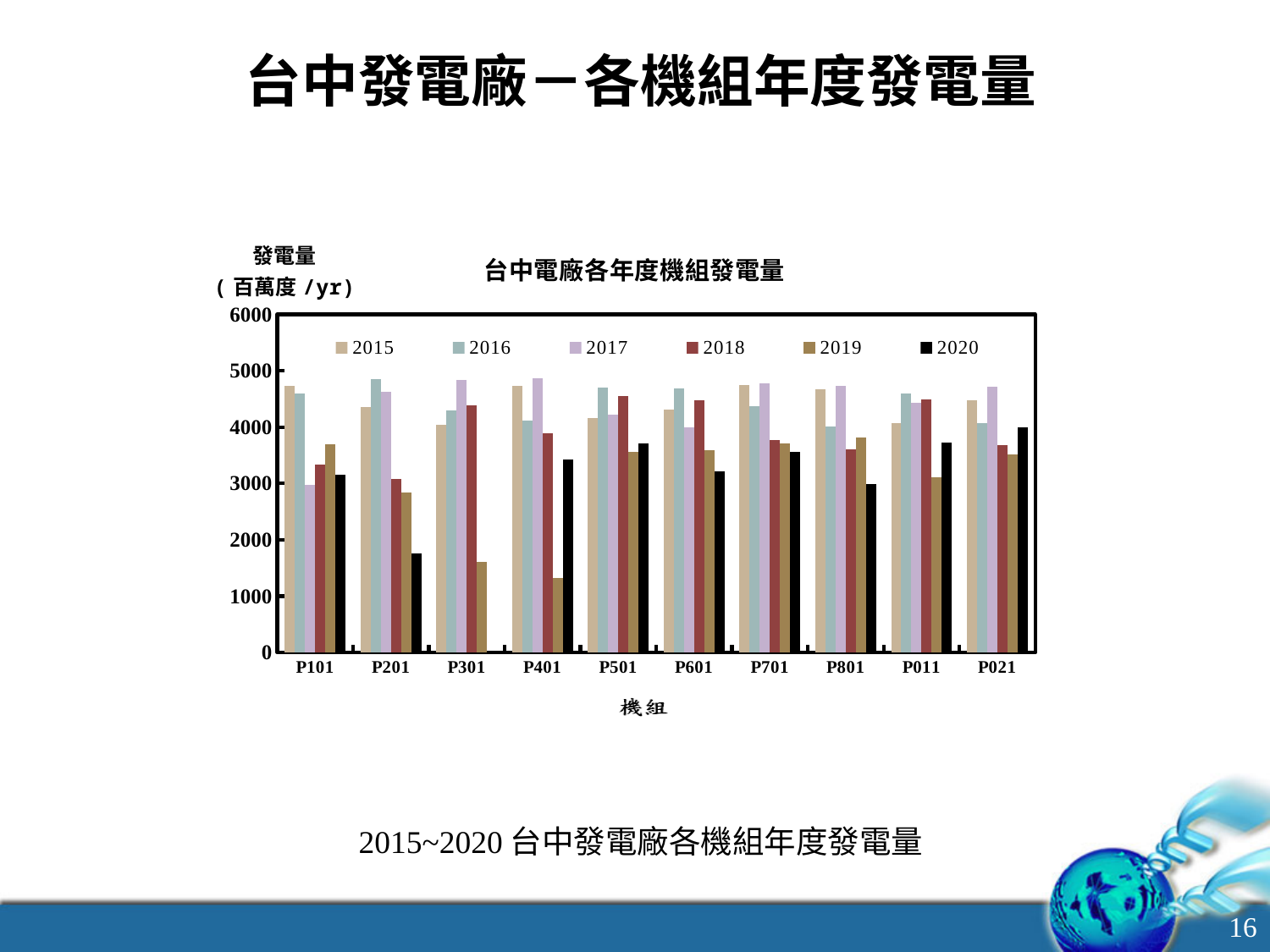
Is the 2019 value for P301 greater or less than 2000? less How many series does the legend list? 6 What kind of chart is shown on the slide? bar chart For unit P201, which is larger: the 2015 value or the 2020 value? 2015 Is the 2019 value for P401 greater or less than 2000? less What is the title printed above the chart? 台中電廠各年度機組發電量 For unit P401, which year has the lowest value? 2019 How many generating units (categories) are shown on the x axis? 10 Is the 2020 value for P201 greater or less than 2000? less For unit P201, which year has the lowest value? 2020 What is the label of the x axis? 機組